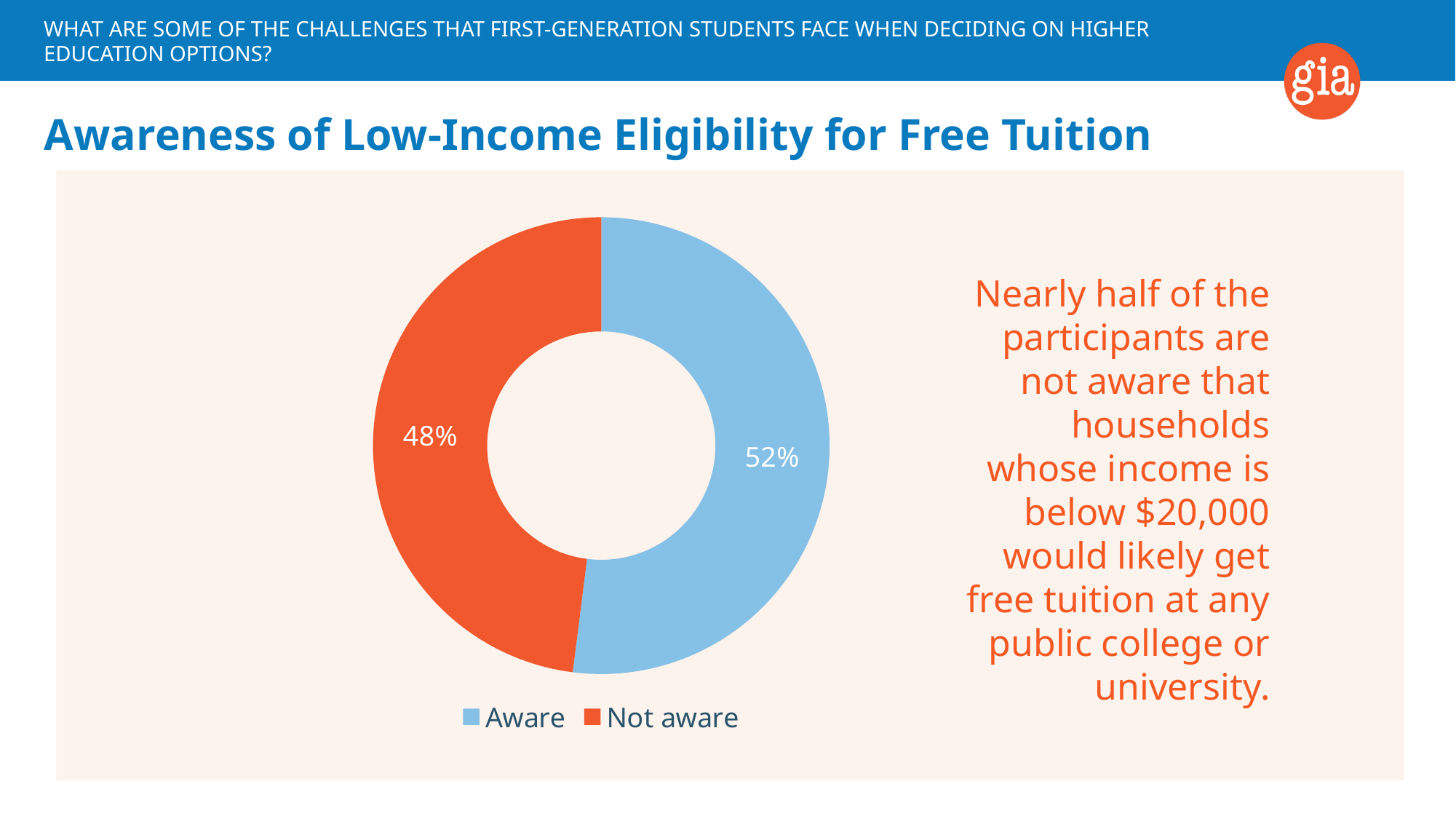
Which category has the larger share: Aware or Not aware? Aware How many categories does the chart show? 2 What share of the chart does the Not aware slice represent? 48% Is the share for Aware larger or smaller than the share for Not aware? larger How many entries does the legend list? 2 What percentage of participants are not aware of low-income eligibility for free tuition? 48% Which category has the smaller share of the chart? Not aware What colour is the Not aware slice? Orange What is the difference in percentage points between the Aware and Not aware shares? 4 What is the title of the chart? Awareness of Low-Income Eligibility for Free Tuition What kind of chart is shown on the slide? Doughnut (pie) chart What percentage of participants are aware of low-income eligibility for free tuition? 52%